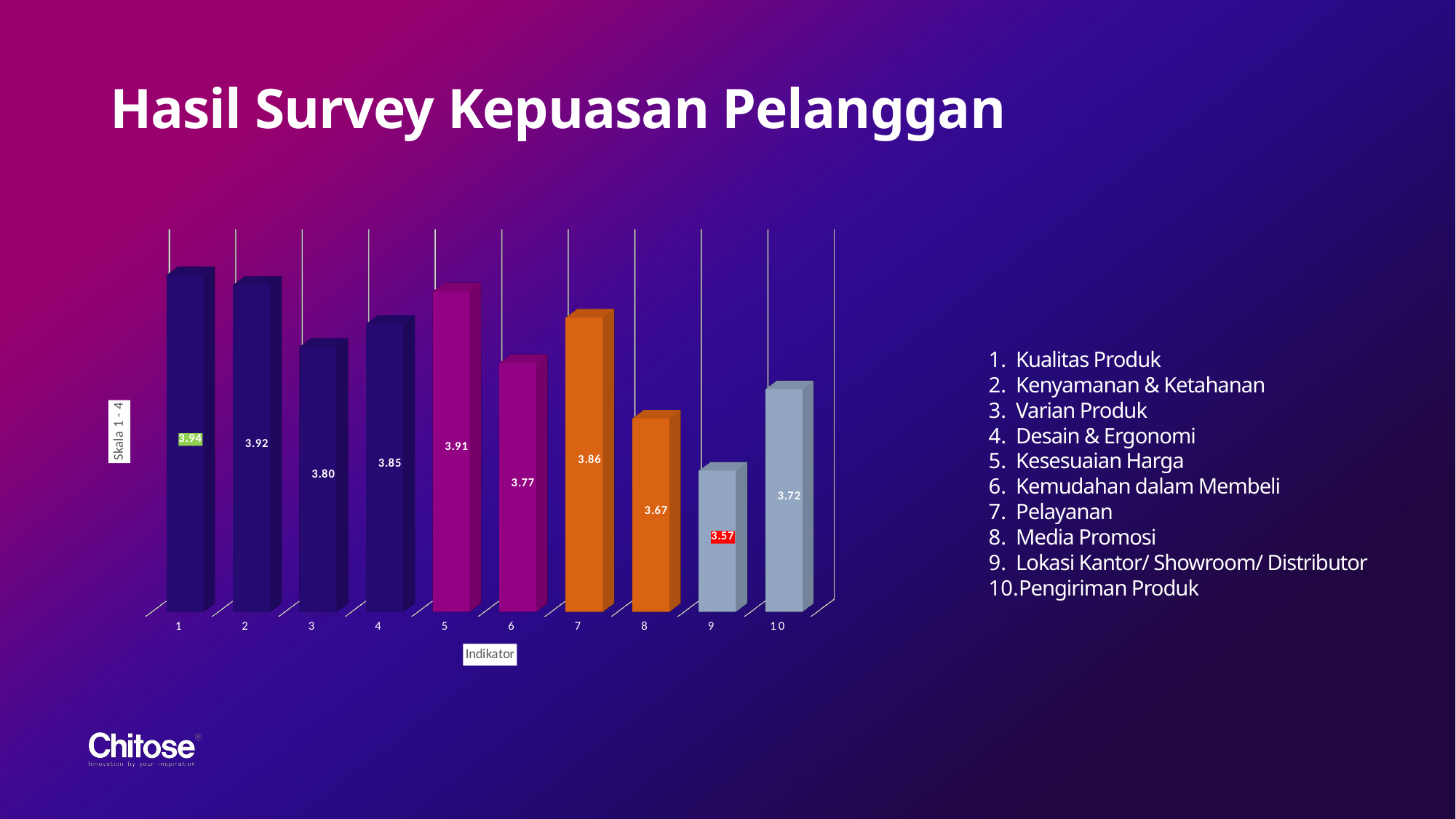
What is the value for indicator 7 (Pelayanan)? 3.86 What is the label of the x axis of the chart? Indikator What is the difference between the values for indicator 5 and indicator 6? 0.14 Which has a higher value, indicator 4 (Desain & Ergonomi) or indicator 8 (Media Promosi)? Indicator 4 (Desain & Ergonomi) Which indicator has the highest value? 1 (Kualitas Produk) What is the label of the y axis of the chart? Skala 1 - 4 What kind of chart is shown on the slide? Bar chart What is the difference between the values for indicator 1 and indicator 9? 0.37 What is the value for indicator 1 (Kualitas Produk)? 3.94 What is the value for indicator 10 (Pengiriman Produk)? 3.72 How many indicators are plotted in the chart? 10 Which indicator has the lowest value? 9 (Lokasi Kantor/ Showroom/ Distributor)